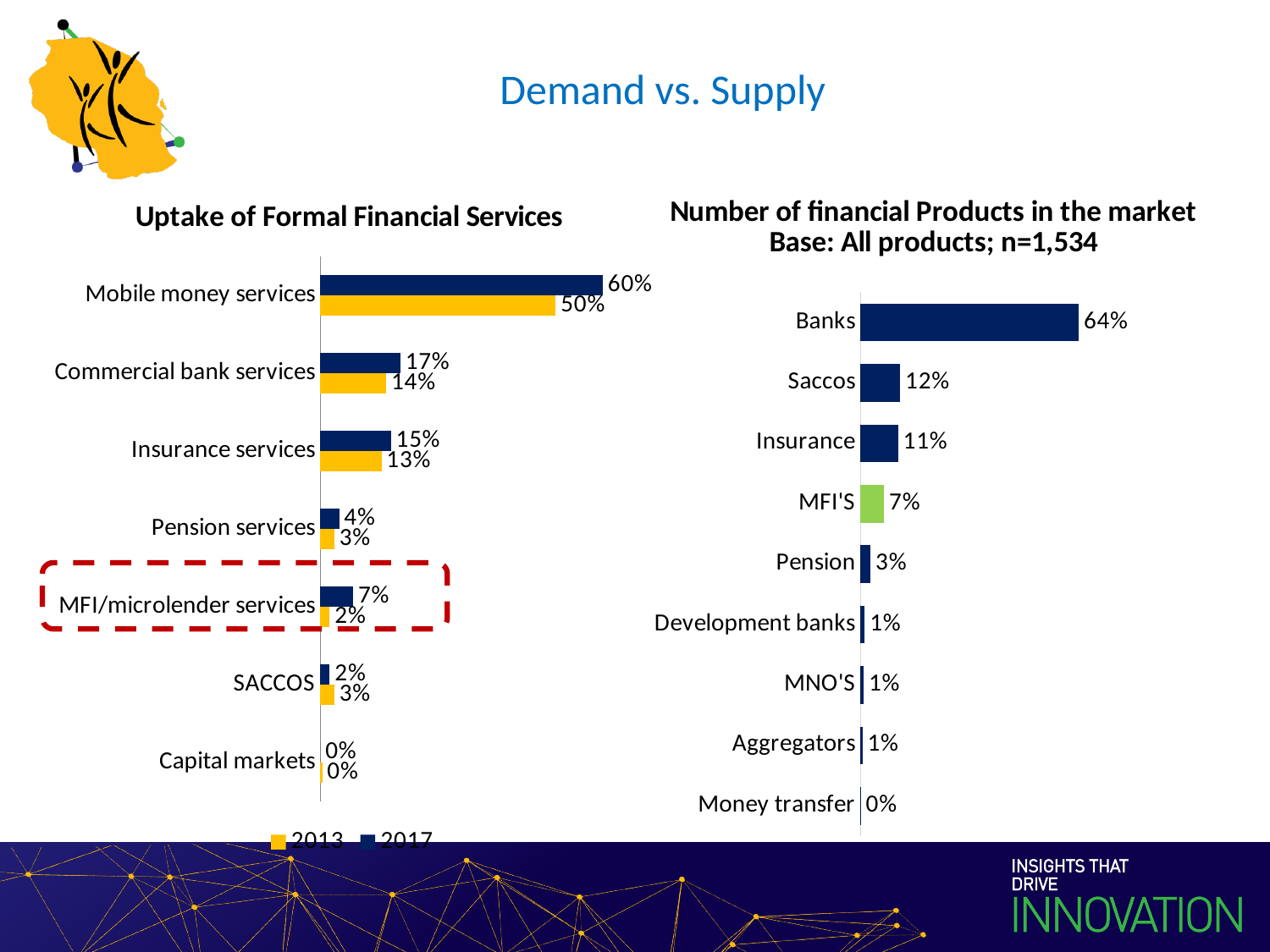
What type of chart is the 'Number of financial Products in the market' chart? Bar chart In the 'Uptake of Formal Financial Services' chart, what is the difference between the 2017 and 2013 values for Commercial bank services? 3% In the 'Number of financial Products in the market' chart, which category has the highest value? Banks In the 'Uptake of Formal Financial Services' chart, how many service categories are shown? 7 In the 'Uptake of Formal Financial Services' chart, what is the 2013 value for MFI/microlender services? 2% In the 'Uptake of Formal Financial Services' chart, which is larger for SACCOS, the 2013 value or the 2017 value? 2013 In the 'Number of financial Products in the market' chart, which category has the lowest value? Money transfer In the 'Number of financial Products in the market' chart, how many categories are shown? 9 In the 'Number of financial Products in the market' chart, what is the difference between Banks and Saccos? 52% In the 'Number of financial Products in the market' chart, what is the value for Insurance? 11% In the 'Uptake of Formal Financial Services' chart, how many series does the legend list? 2 In the 'Uptake of Formal Financial Services' chart, what is the 2017 value for Mobile money services? 60%